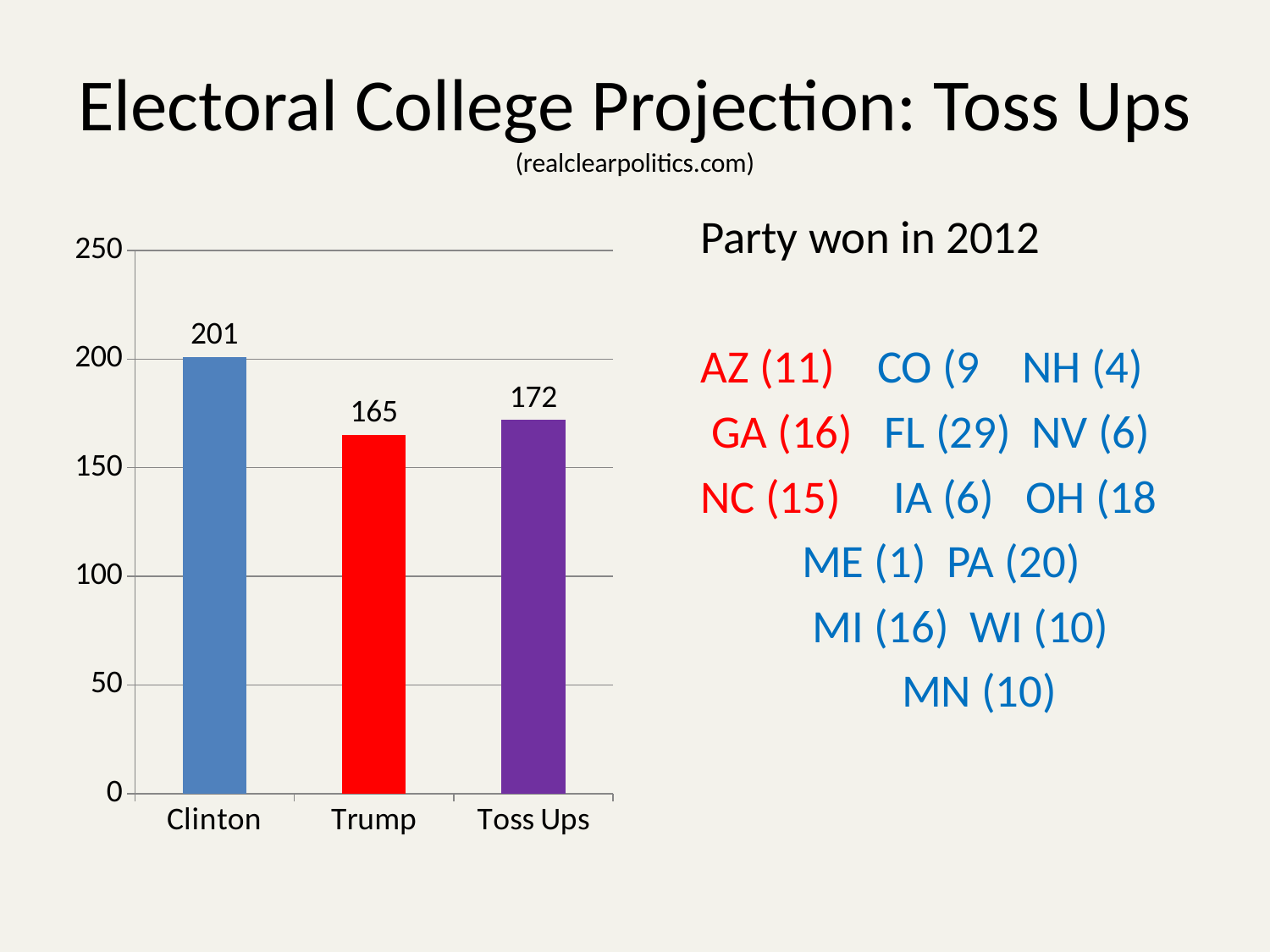
What kind of chart is shown on the slide? bar chart Which category has the lowest value? Trump What is the difference between the values for Toss Ups and Trump? 7 What is the value for Trump? 165 What is the difference between the values for Clinton and Trump? 36 How many categories are shown on the chart? 3 Which category has the highest value? Clinton What is the value for Toss Ups? 172 Which is larger, the value for Clinton or the value for Toss Ups? Clinton Is the value for Trump greater or less than 150? greater What colour is the bar for Trump? red What is the value for Clinton? 201